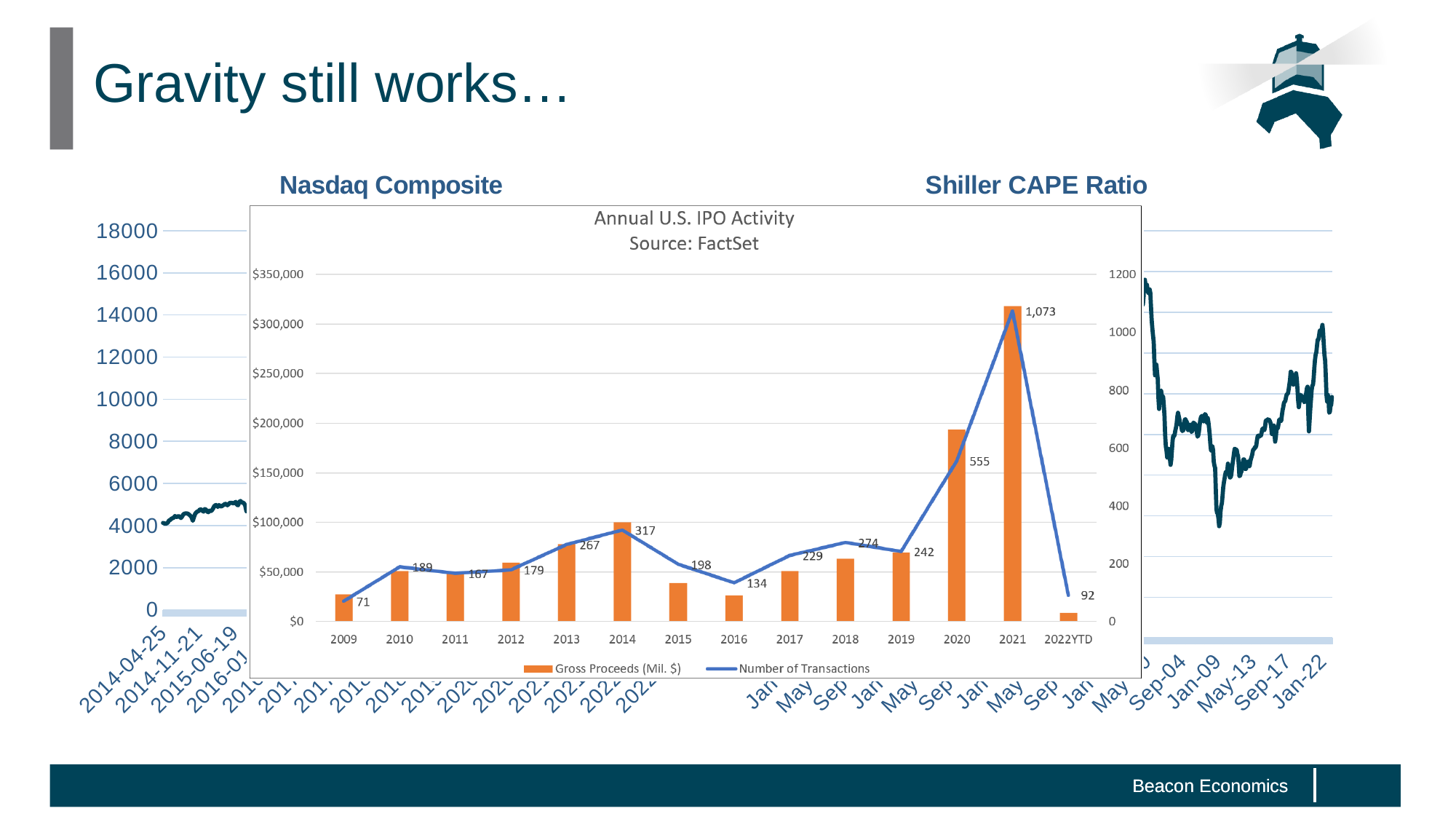
In the Annual U.S. IPO Activity chart, which year had more transactions, 2013 or 2014? 2014 In the Annual U.S. IPO Activity chart, is the Gross Proceeds value for 2020 greater or less than $200,000? less In the Annual U.S. IPO Activity chart, is the Gross Proceeds value for 2021 greater or less than $300,000? greater In the Annual U.S. IPO Activity chart, by how much did the Number of Transactions in 2021 exceed that of 2020? 518 What is the source cited in the title of the Annual U.S. IPO Activity chart? FactSet How many years (categories) are shown on the x axis of the Annual U.S. IPO Activity chart? 14 In the Annual U.S. IPO Activity chart, what was the Number of Transactions in 2020? 555 In the Annual U.S. IPO Activity chart, which year had the highest Number of Transactions? 2021 In the Annual U.S. IPO Activity chart, what was the Number of Transactions in 2021? 1,073 How many series does the legend of the Annual U.S. IPO Activity chart list? 2 In the Annual U.S. IPO Activity chart, which year had the lowest Number of Transactions? 2009 In the Annual U.S. IPO Activity chart, what was the Number of Transactions in 2009? 71